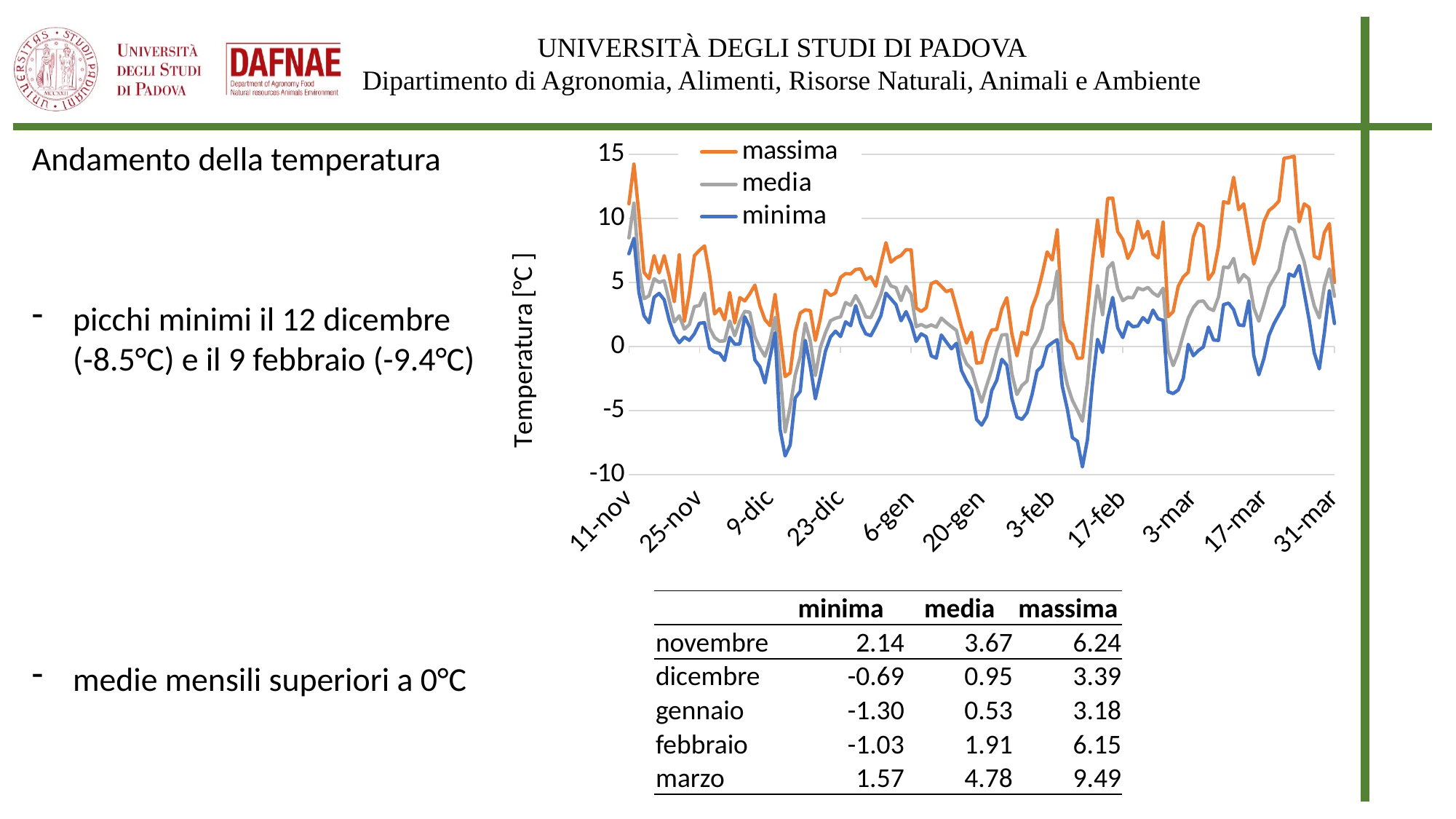
What is the title of the chart's vertical axis? Temperatura [°C] Is the value of the massima series at the start of the chart (11-nov) greater or less than 10? greater Is the lowest value of the minima series around 9-dic greater or less than -5? less How many series does the chart legend list? 3 Which series in the chart has the lowest values throughout the period? minima Is the lowest value of the minima series shortly after 3-feb greater or less than -5? less Which series has higher values across the whole period, massima or minima? massima What are the three series named in the chart legend? massima, media, minima How many date labels are shown on the chart's x axis? 11 What kind of chart is shown on the slide? line chart According to the slide, what minimum temperature was reached on 9 febbraio? -9.4°C